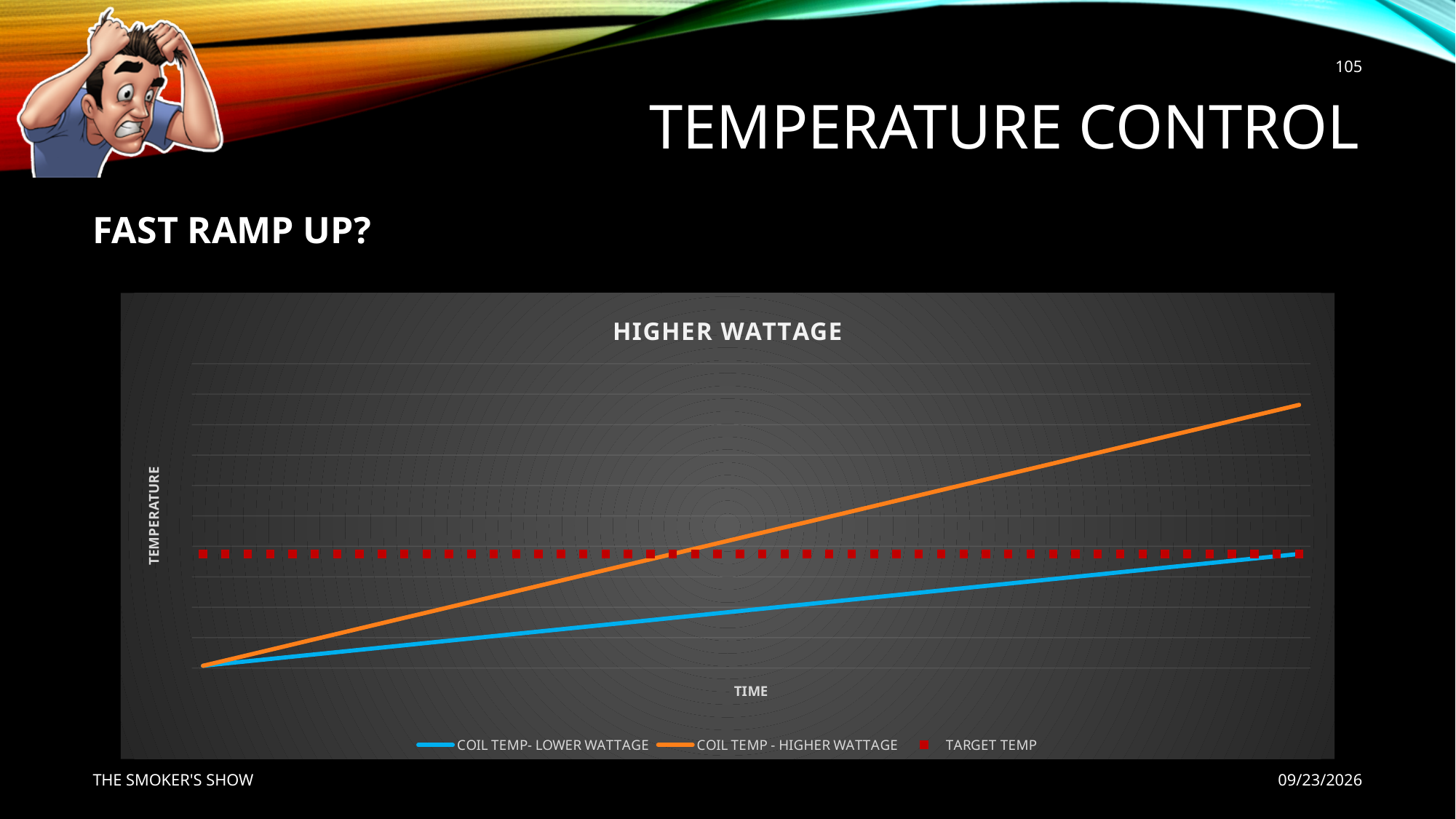
Does the Target Temp series rise, fall, or stay flat over time? Stays flat Which series reaches the highest temperature at the end of the time axis? Coil Temp - Higher Wattage Which series rises more steeply over time, Coil Temp - Higher Wattage or Coil Temp- Lower Wattage? Coil Temp - Higher Wattage Does the Coil Temp - Higher Wattage line rise or fall as time increases? Rises At the right end of the chart, which is higher: Coil Temp - Higher Wattage or Coil Temp- Lower Wattage? Coil Temp - Higher Wattage What label is shown on the vertical axis of the chart? TEMPERATURE What is the title of the chart? HIGHER WATTAGE How many series does the legend of the Higher Wattage chart list? 3 At the right end of the chart, which is higher: Coil Temp - Higher Wattage or Target Temp? Coil Temp - Higher Wattage What kind of chart is shown on the slide? Line chart Does the Coil Temp- Lower Wattage line rise or fall along the time axis? Rises